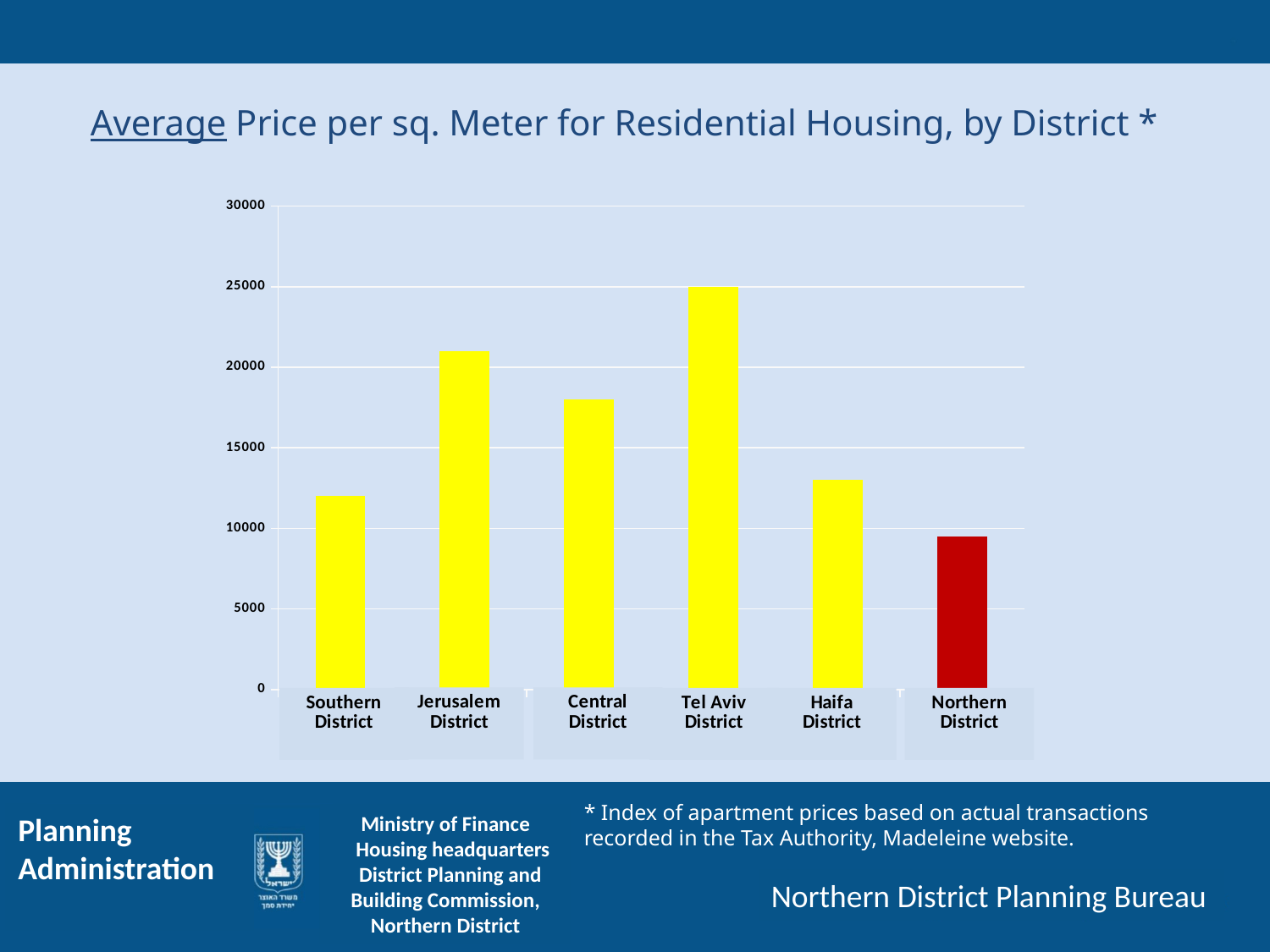
How many districts are shown on the chart? 6 Which has a higher average price per sq. meter, Jerusalem District or Central District? Jerusalem District Which has a higher average price per sq. meter, Haifa District or Southern District? Haifa District Is the value for Jerusalem District greater or less than 20000? greater Which district has the lowest average price per sq. meter? Northern District Is the value for Southern District greater or less than 10000? greater What is the title of the chart? Average Price per sq. Meter for Residential Housing, by District * Which district's bar is coloured red instead of yellow? Northern District Is the value for Northern District greater or less than 10000? less Which district has the highest average price per sq. meter? Tel Aviv District What kind of chart is shown on the slide? bar chart